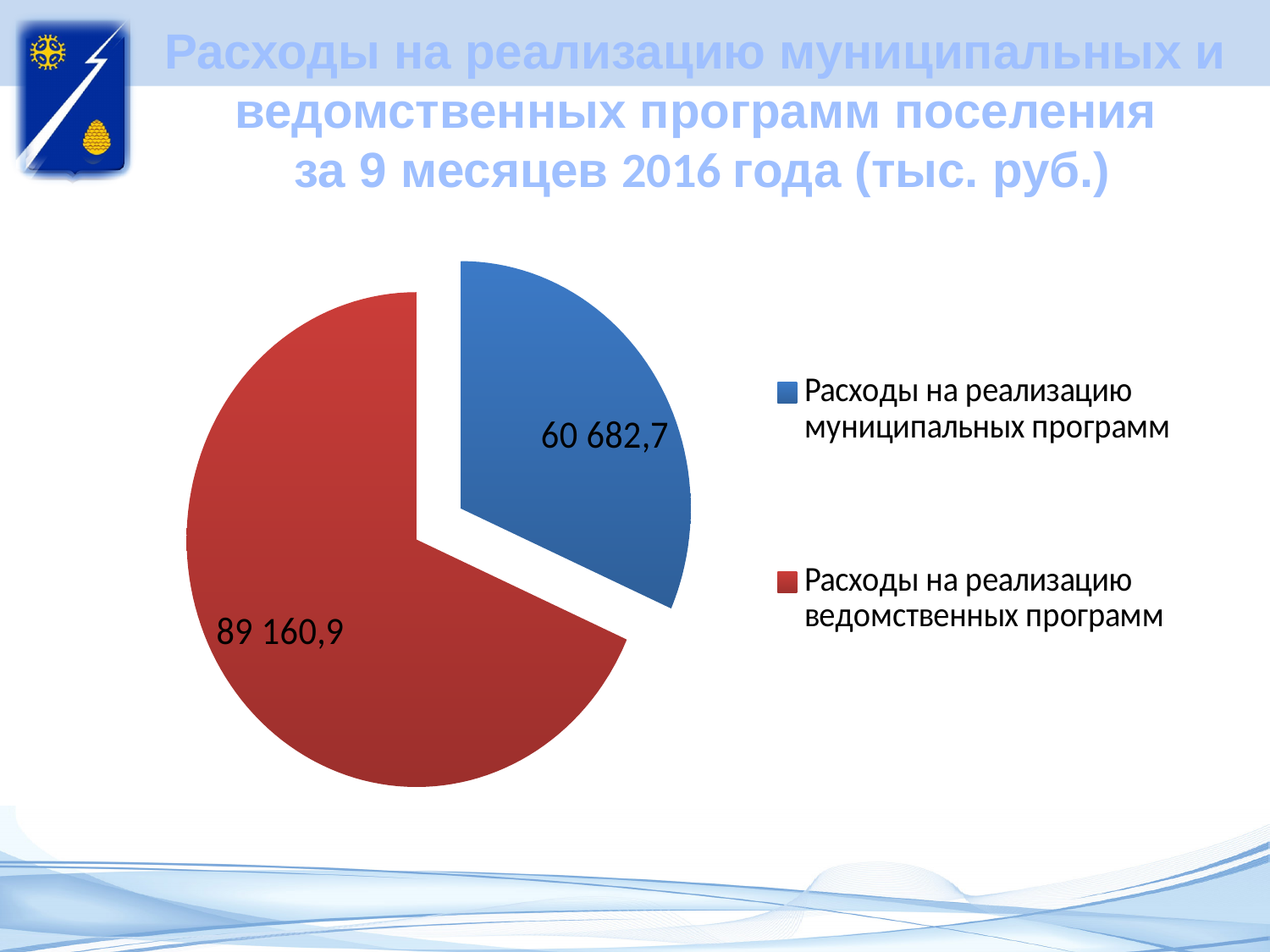
What is the difference between the value for ведомственных программ and the value for муниципальных программ? 28 478,2 What is the value for Расходы на реализацию муниципальных программ? 60 682,7 What is the value for Расходы на реализацию ведомственных программ? 89 160,9 What kind of chart is shown on the slide? pie chart How many slices does the pie chart have? 2 Which category has the largest slice of the pie? Расходы на реализацию ведомственных программ What is the total of the two slices in the pie chart? 149 843,6 Which category has the smallest slice of the pie? Расходы на реализацию муниципальных программ What colour is the slice for Расходы на реализацию муниципальных программ? blue Which is larger: the value for муниципальных программ or the value for ведомственных программ? ведомственных программ How many entries does the legend list? 2